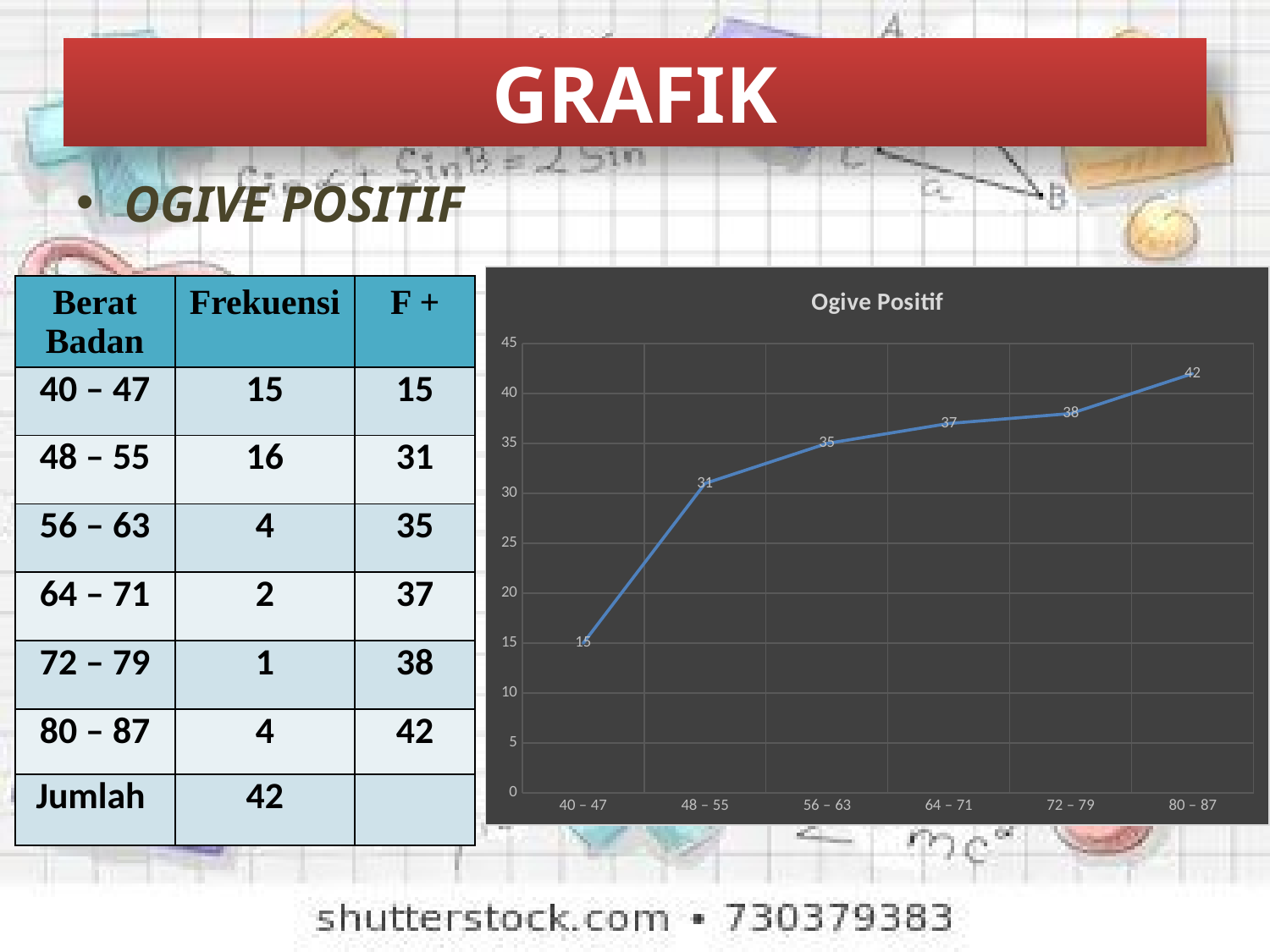
Which is larger, the value for 56 – 63 or the value for 72 – 79? 72 – 79 How many categories are plotted on the x axis? 6 What is the value plotted for the 80 – 87 category? 42 Do the values rise or fall from left to right along the x axis? rise What is the value plotted for the 48 – 55 category? 31 Which category has the lowest value in the chart? 40 – 47 What kind of chart is shown on the slide? line chart What is the title of the chart? Ogive Positif What is the difference between the values for 48 – 55 and 40 – 47? 16 Which category has the highest value in the chart? 80 – 87 Is the value for 56 – 63 greater or less than 30? greater What is the value plotted for the 64 – 71 category? 37